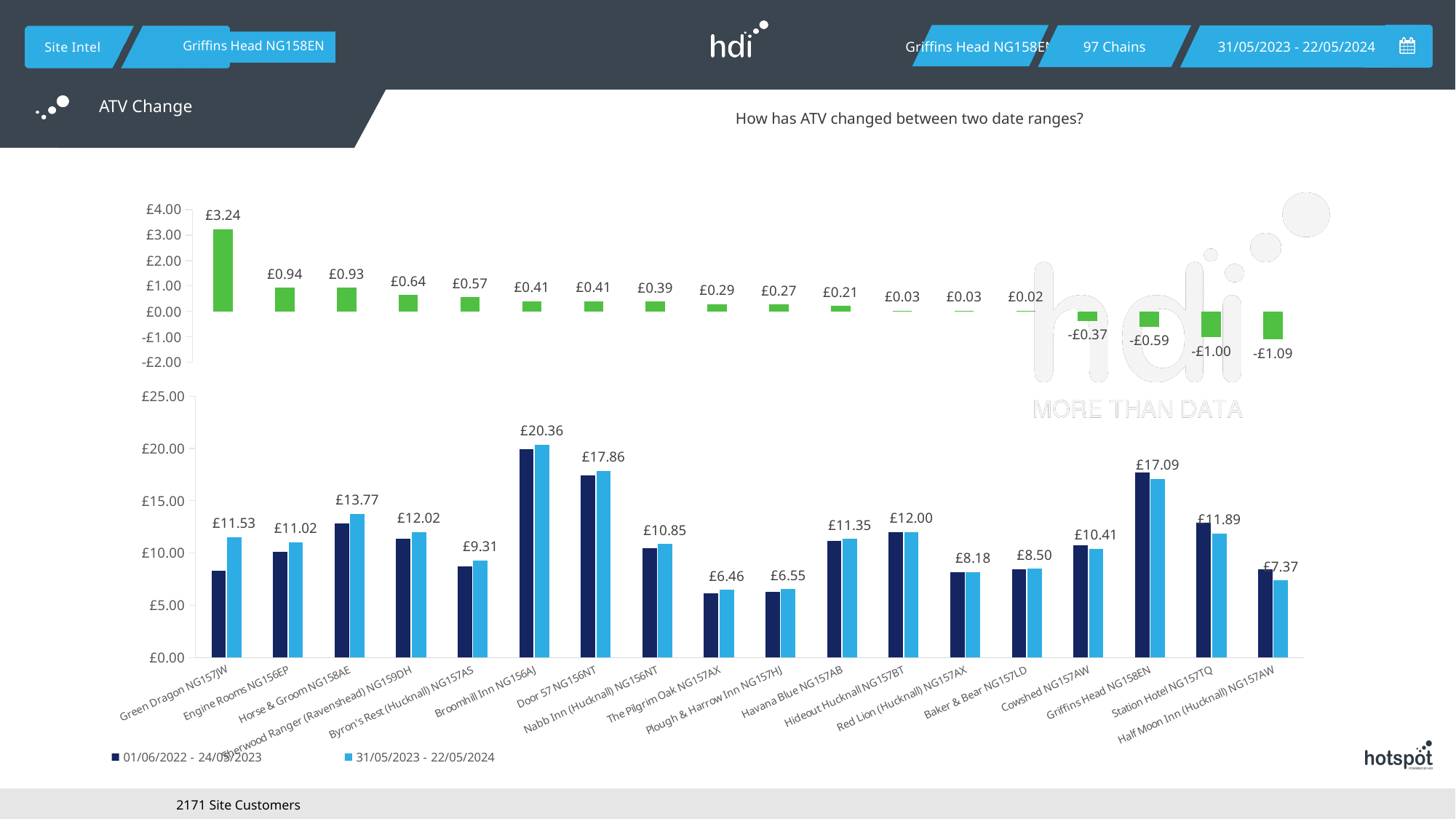
In the bottom chart, for Green Dragon NG157JW, which series has the larger bar: 01/06/2022 - 24/05/2023 or 31/05/2023 - 22/05/2024? 31/05/2023 - 22/05/2024 In the top chart, what is the highest labelled value? £3.24 In the bottom chart, which site has the lowest labelled value? The Pilgrim Oak NG157AX What kind of chart is the bottom chart? bar chart How many sites are shown on the x axis of the bottom chart? 18 In the bottom chart, is the 01/06/2022 - 24/05/2023 value for Green Dragon NG157JW greater or less than £10.00? less In the top chart, what is the lowest labelled value? -£1.09 In the bottom chart, what is the labelled value for Broomhill Inn NG156AJ? £20.36 How many series does the legend of the bottom chart list? 2 In the bottom chart, what is the labelled value for The Pilgrim Oak NG157AX? £6.46 In the bottom chart, what is the difference between the labelled values for Broomhill Inn NG156AJ and Door 57 NG156NT? £2.50 In the bottom chart, which site has the highest labelled value? Broomhill Inn NG156AJ